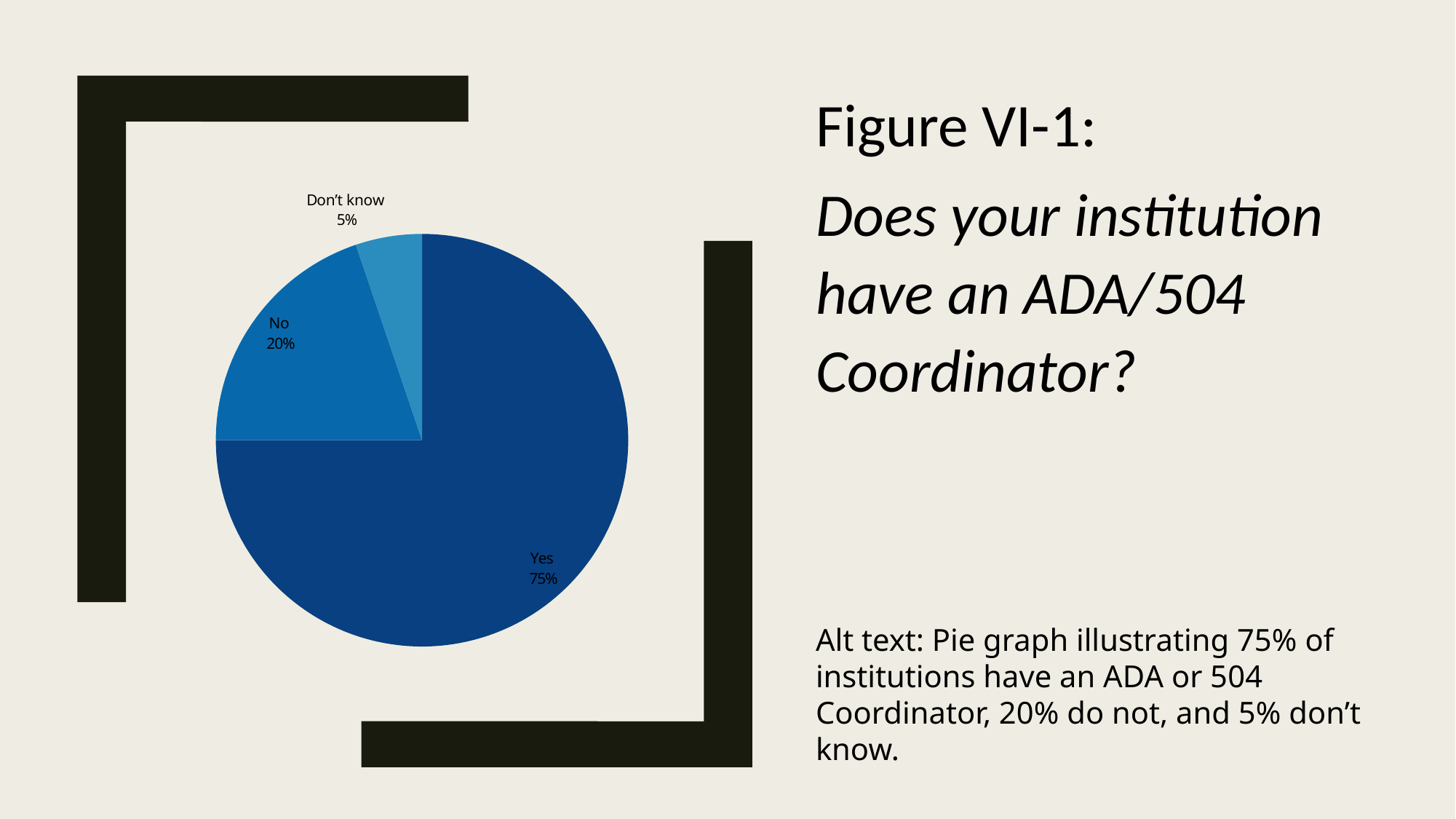
What share of the pie do the "No" and "Don't know" slices make up together? 25% What percentage of institutions answered "No"? 20% What question does the chart on the slide address, according to the title? Does your institution have an ADA/504 Coordinator? How many slices does the pie chart have? 3 Which response has the largest share of the pie? Yes Which slice is larger, "No" or "Don't know"? No What is the difference in percentage points between the "Yes" and "No" slices? 55 What percentage of institutions answered "Yes" to having an ADA/504 Coordinator? 75% What kind of chart is shown on the slide? Pie chart What is the difference in percentage points between the "No" and "Don't know" slices? 15 Which response has the smallest share of the pie? Don't know What percentage of institutions answered "Don't know"? 5%